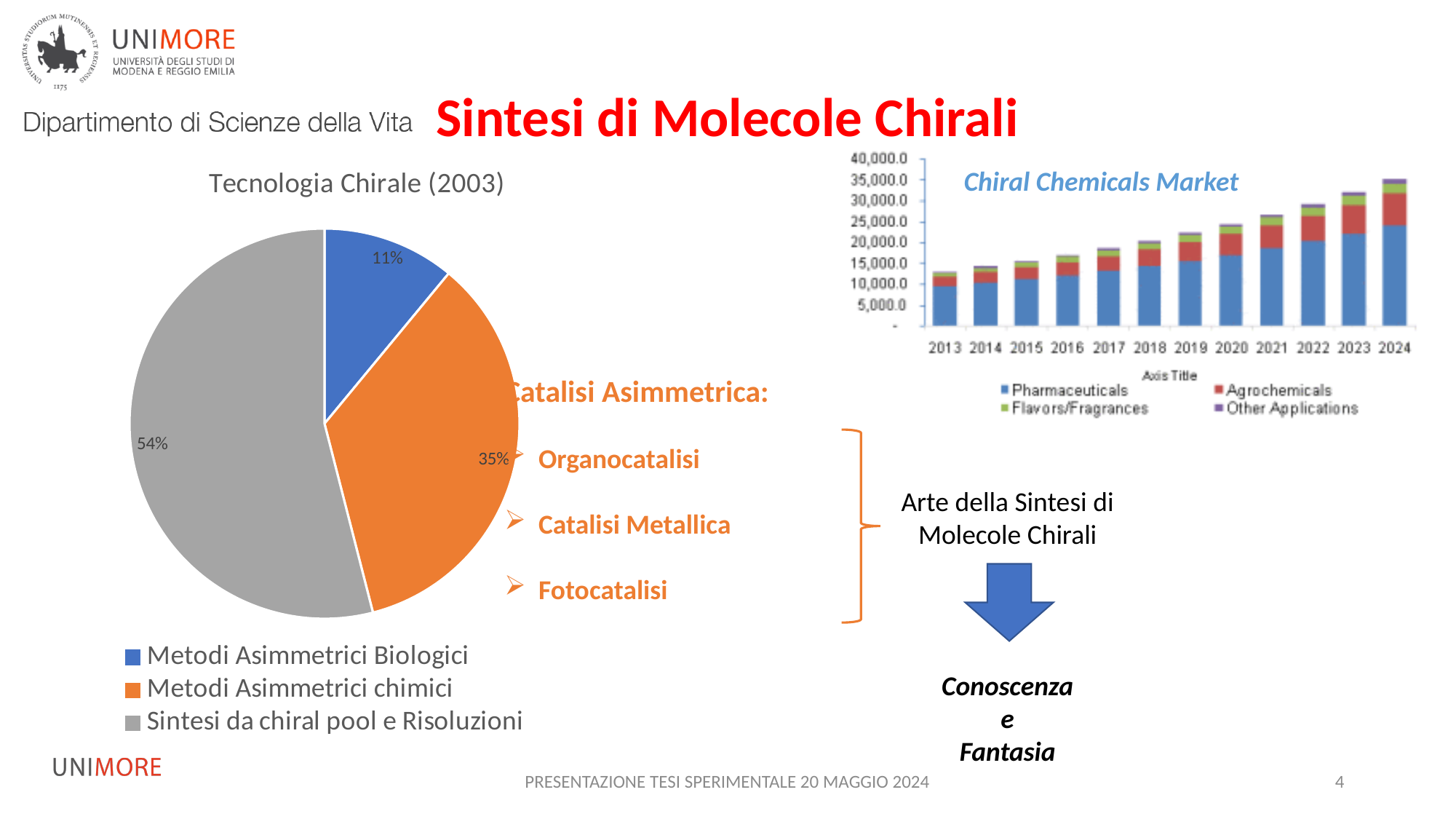
In the pie chart 'Tecnologia Chirale (2003)', what share is shown for Metodi Asimmetrici Biologici? 11% In the pie chart 'Tecnologia Chirale (2003)', how many categories does the legend list? 3 What type of chart is 'Tecnologia Chirale (2003)'? pie chart In the pie chart 'Tecnologia Chirale (2003)', what is the difference in percentage points between Metodi Asimmetrici chimici and Metodi Asimmetrici Biologici? 24 In the pie chart 'Tecnologia Chirale (2003)', what share is shown for Sintesi da chiral pool e Risoluzioni? 54% What type of chart is 'Chiral Chemicals Market'? stacked bar chart In the 'Chiral Chemicals Market' chart, how many series does the legend list? 4 In the 'Chiral Chemicals Market' chart, do the total bar heights rise or fall from 2013 to 2024? rise In the 'Chiral Chemicals Market' chart, is the Pharmaceuticals value for 2024 greater or less than 20,000.0? greater In the pie chart 'Tecnologia Chirale (2003)', which category has the largest slice? Sintesi da chiral pool e Risoluzioni In the pie chart 'Tecnologia Chirale (2003)', which category has the smallest slice? Metodi Asimmetrici Biologici In the 'Chiral Chemicals Market' chart, how many years are shown on the x axis? 12